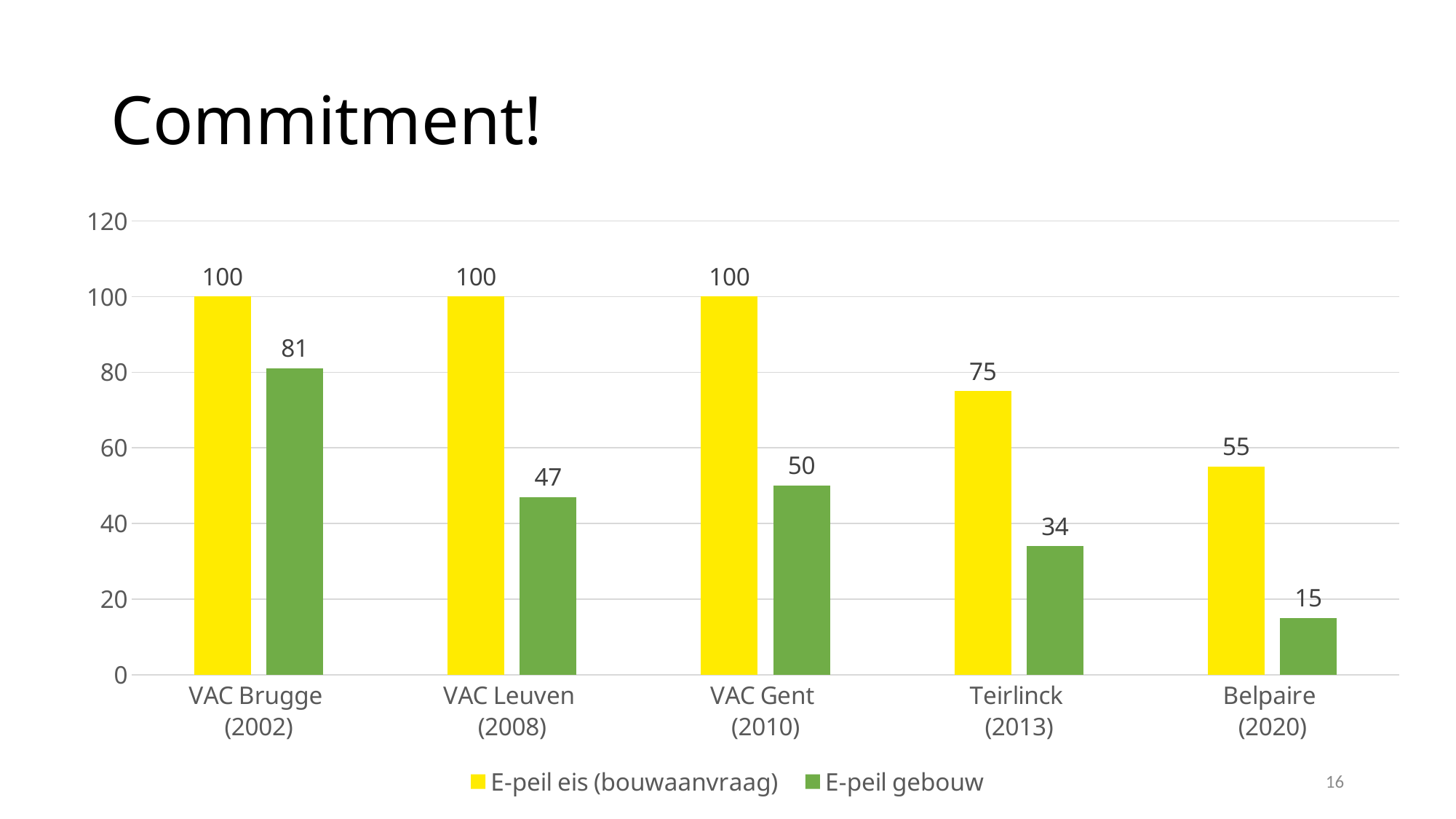
Which category has the lowest E-peil gebouw value? Belpaire (2020) Which category has the highest E-peil gebouw value? VAC Brugge (2002) What is the E-peil eis (bouwaanvraag) value for Teirlinck (2013)? 75 How many series does the legend list? 2 Which is larger: the E-peil gebouw value for VAC Leuven (2008) or for VAC Gent (2010)? VAC Gent (2010) What is the E-peil gebouw value for VAC Brugge (2002)? 81 What is the difference between the E-peil eis (bouwaanvraag) and E-peil gebouw values for VAC Gent (2010)? 50 What is the E-peil gebouw value for Belpaire (2020)? 15 How many categories are shown on the x axis? 5 What is the difference between the E-peil gebouw values for VAC Leuven (2008) and Teirlinck (2013)? 13 Do the E-peil gebouw values rise or fall from VAC Brugge (2002) to Belpaire (2020)? Fall What kind of chart is shown on the slide? Bar chart